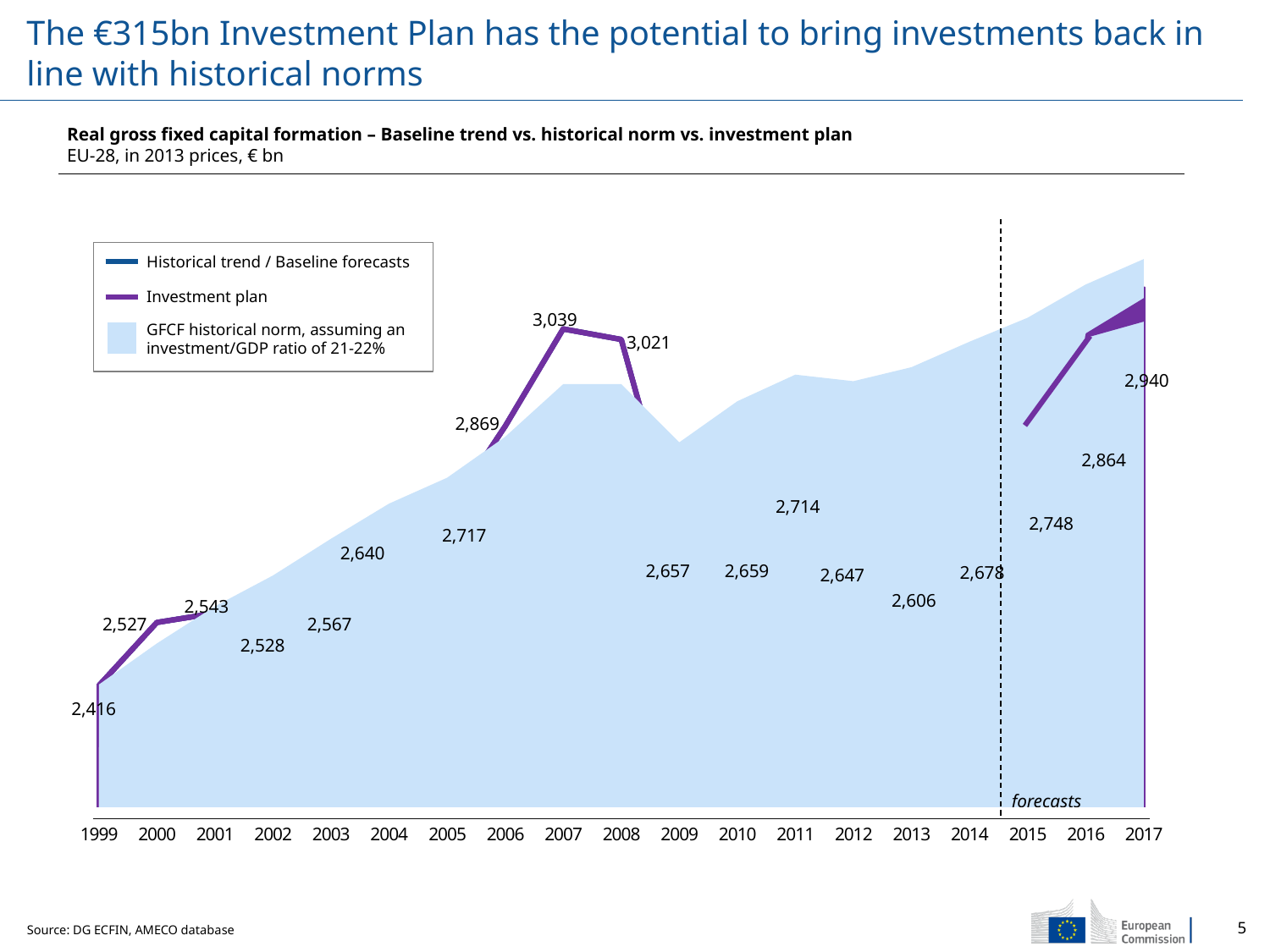
Which year has the highest labelled value? 2007 Which year has the lowest labelled value? 1999 What is the difference between the labelled values for 2007 and 2008? 18 What is the data label shown for 1999? 2,416 What is the difference between the labelled values for 2017 and 2015? 192 What is the data label shown for 2017? 2,940 Do the labelled values rise or fall from 2014 to 2017? rise How many entries does the legend list? 3 How many years are shown on the x axis? 19 What is the data label shown for 2013? 2,606 Which is larger, the labelled value for 2011 or for 2012? 2011 What is the data label shown for 2007? 3,039